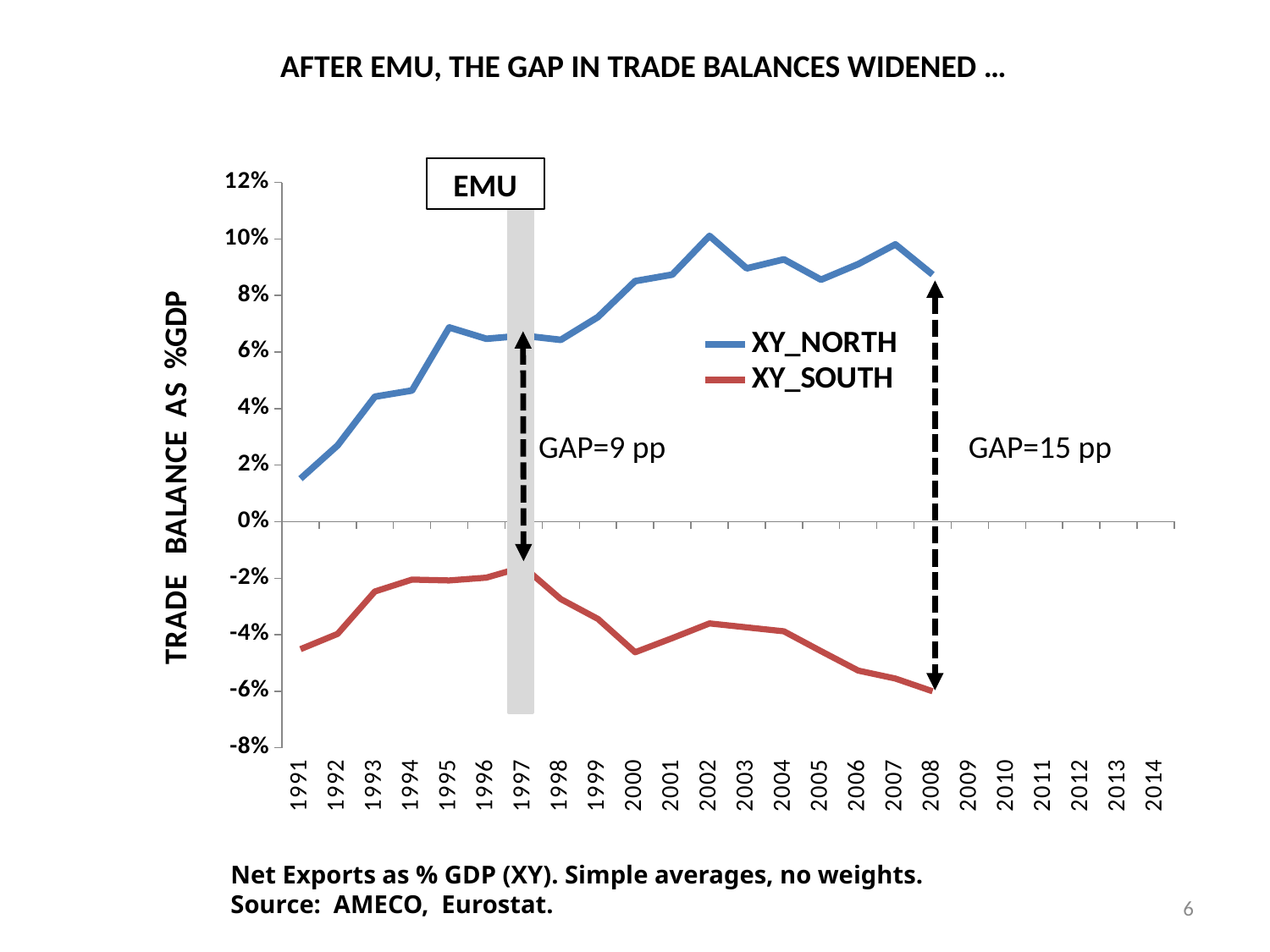
Is the value for XY_SOUTH in 2000 greater or less than -4%? less What gap in percentage points is annotated at 2008? 15 pp Is the value for XY_NORTH in 1991 greater or less than 2%? less In which year does the XY_NORTH series have its lowest value? 1991 Does the XY_SOUTH series rise or fall between 1996 and 2008? Fall What gap in percentage points is annotated at 1997, the EMU year? GAP=9 pp In which year does the XY_NORTH series reach its highest value? 2002 Which two series are listed in the chart legend? XY_NORTH and XY_SOUTH How many series does the legend list? 2 In which year does the XY_SOUTH series reach its lowest value? 2008 Which series has the higher value in 2008, XY_NORTH or XY_SOUTH? XY_NORTH What kind of chart is shown on the slide? Line chart